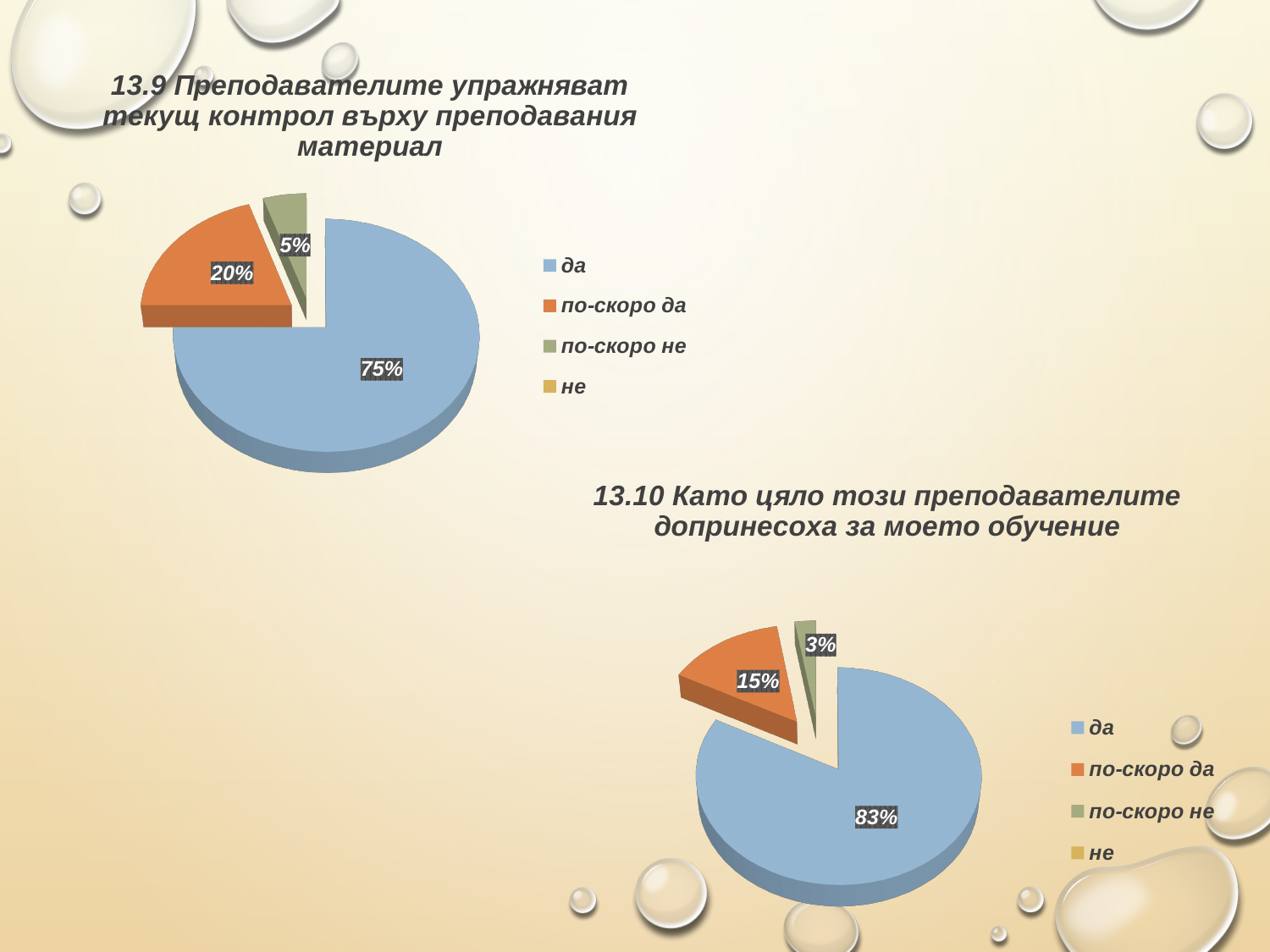
In the chart titled 13.10, what share of responses is "по-скоро не"? 3% In the chart titled 13.10, what is the difference between the "по-скоро да" and "по-скоро не" shares? 12% In the chart titled 13.9, what is the difference between the "да" and "по-скоро да" shares? 55% What type of chart is used for 13.10? Pie chart In the chart titled 13.9, what share of responses is "по-скоро да"? 20% In the chart titled 13.9, what share of responses is "да"? 75% In the chart titled 13.10, which is larger, the "по-скоро да" slice or the "по-скоро не" slice? по-скоро да In the chart titled 13.10, what share of responses is "да"? 83% How many entries does the legend of the chart titled 13.9 list? 4 In the chart titled 13.9, what share of responses is "по-скоро не"? 5% In the chart titled 13.10, what share of responses is "по-скоро да"? 15% In the chart titled 13.9, which category has the largest slice? да